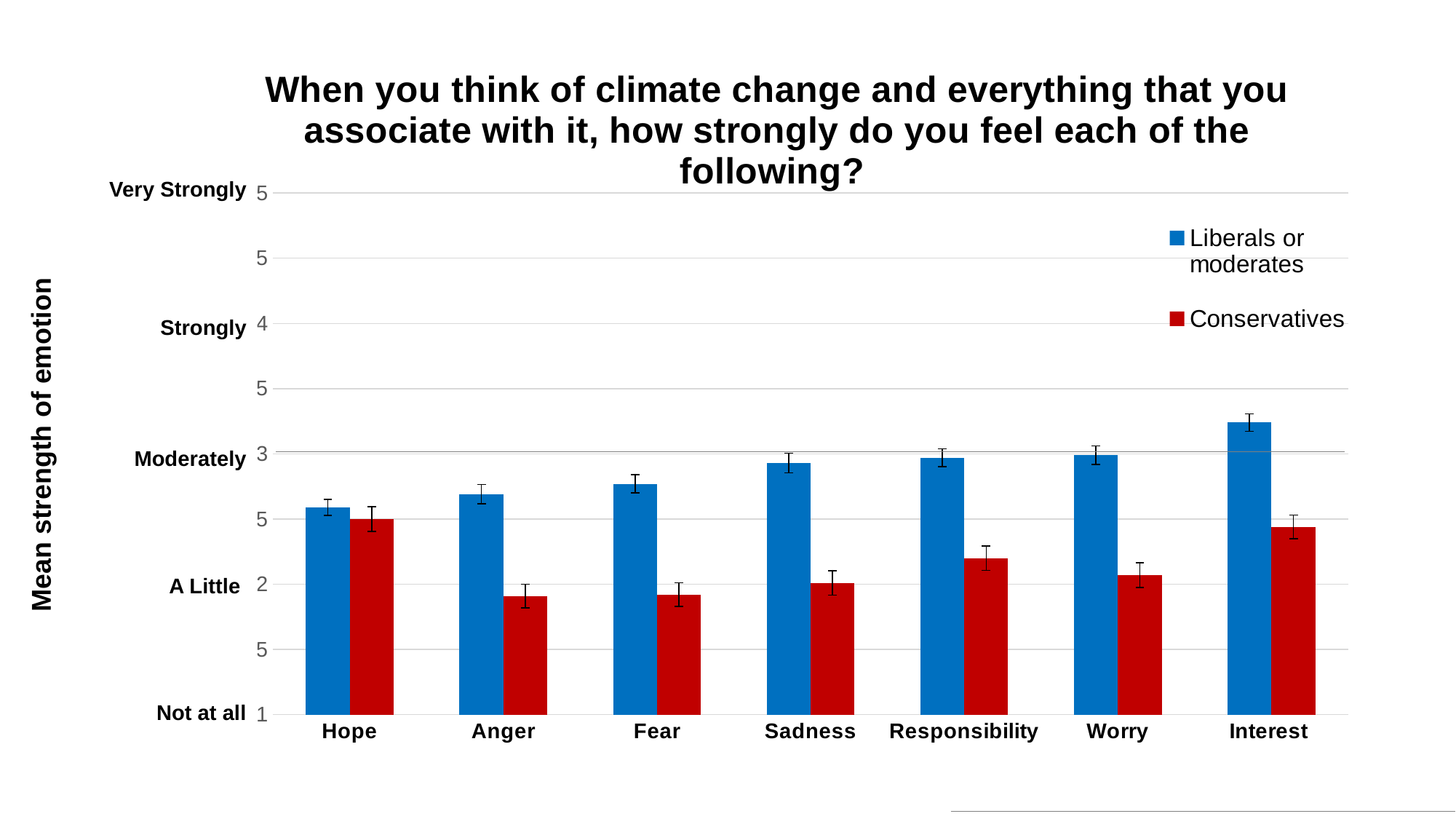
Is the Conservatives value for Responsibility greater or less than 2? greater Is the Liberals or moderates value for Hope greater or less than 3? less How many series does the legend list? 2 What colour are the Conservatives bars? red For Anger, which group has the larger value: Liberals or moderates, or Conservatives? Liberals or moderates What kind of chart is shown on the slide? bar chart Is the Conservatives value for Hope greater or less than 2? greater For which emotion is the Liberals or moderates bar highest? Interest For Interest, which group has the larger value: Liberals or moderates, or Conservatives? Liberals or moderates How many emotion categories are shown on the x axis? 7